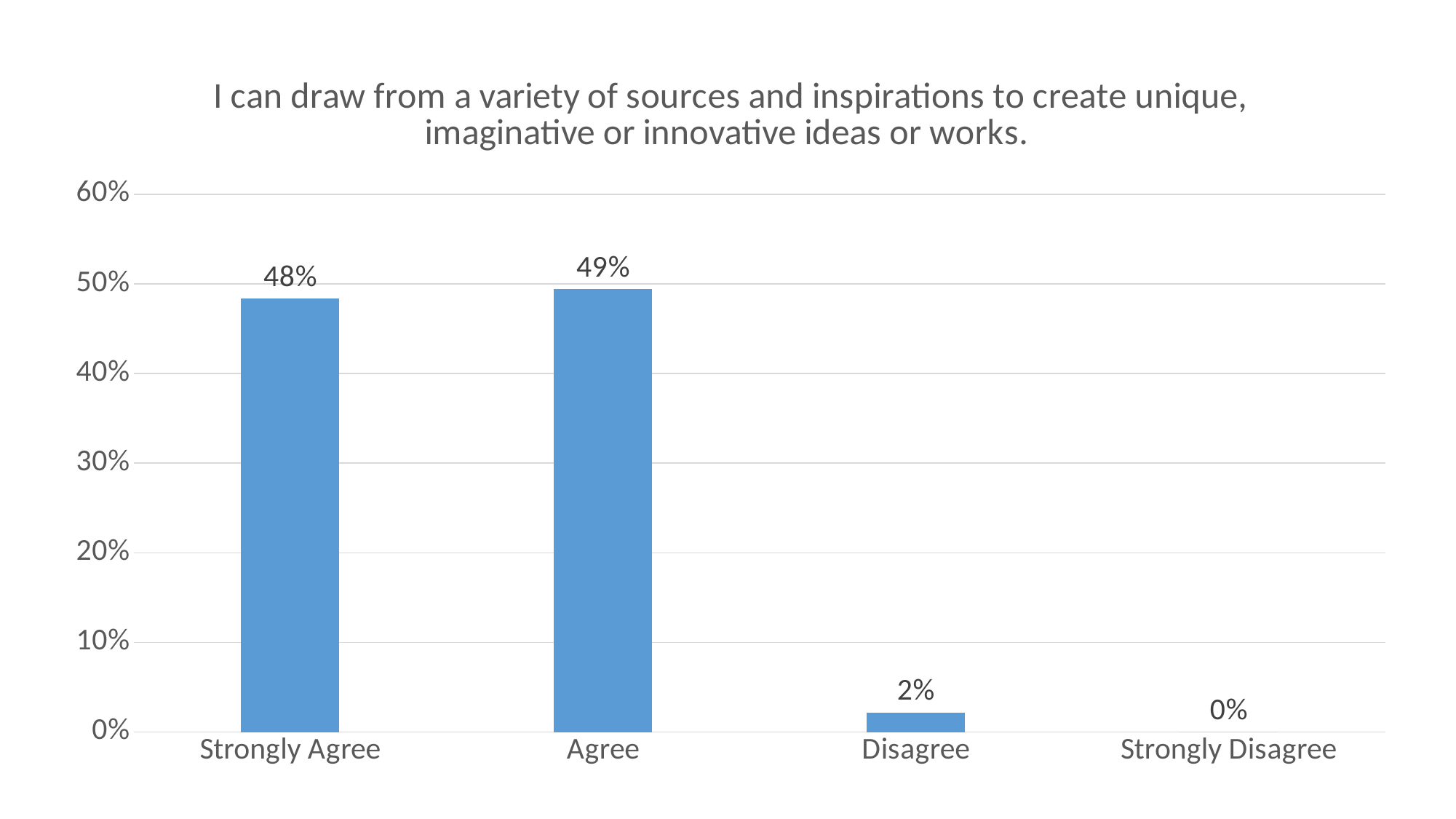
What is the difference between the values for Agree and Strongly Agree? 1% What is the value for Agree? 49% How many categories are shown on the x axis? 4 What kind of chart is this? Bar chart What is the title of the chart? I can draw from a variety of sources and inspirations to create unique, imaginative or innovative ideas or works. Which category has the lowest value? Strongly Disagree What is the value for Strongly Disagree? 0% Which is larger, the value for Strongly Agree or the value for Disagree? Strongly Agree Which category has the highest value? Agree What is the difference between the values for Strongly Agree and Disagree? 46% What is the value for Strongly Agree? 48% What is the value for Disagree? 2%